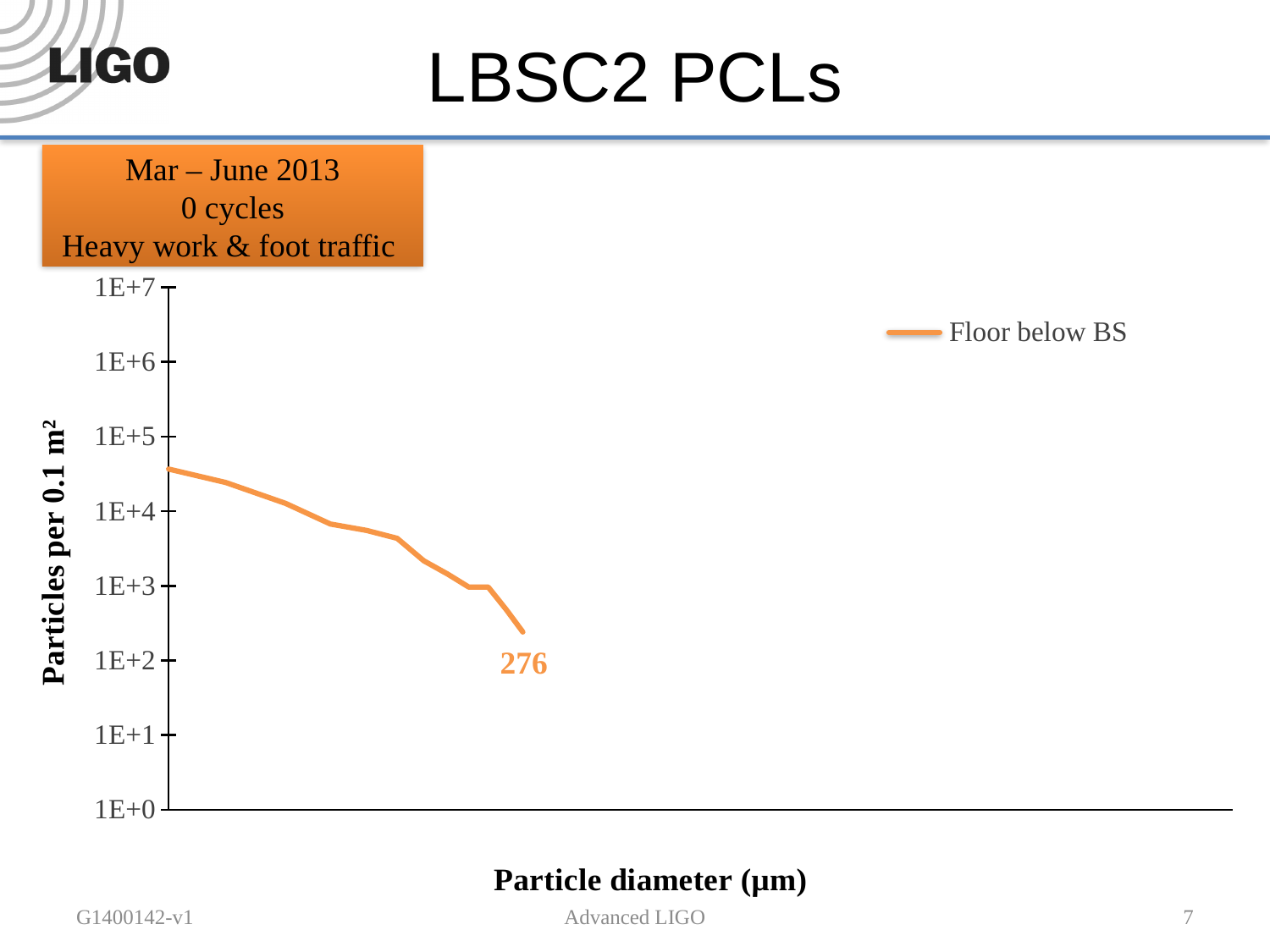
Do the values of the Floor below BS line rise or fall as particle diameter increases along the x axis? fall How many series does the legend list? 1 What is the name of the series shown in the legend? Floor below BS What is the value of the rightmost (last) point of the Floor below BS line? 276 Is the value of the leftmost point of the Floor below BS line greater or less than 1E+4? greater Is the value of the rightmost point of the Floor below BS line greater or less than 1E+3? less What kind of chart is shown on the slide? line chart What is the label of the y axis? Particles per 0.1 m² What is the value printed as a data label on the Floor below BS line? 276 Is the value of the leftmost point of the Floor below BS line greater or less than 1E+5? less Is the leftmost point of the Floor below BS line larger or smaller than the rightmost point? larger Which end of the Floor below BS line, left or right, has the highest value? left